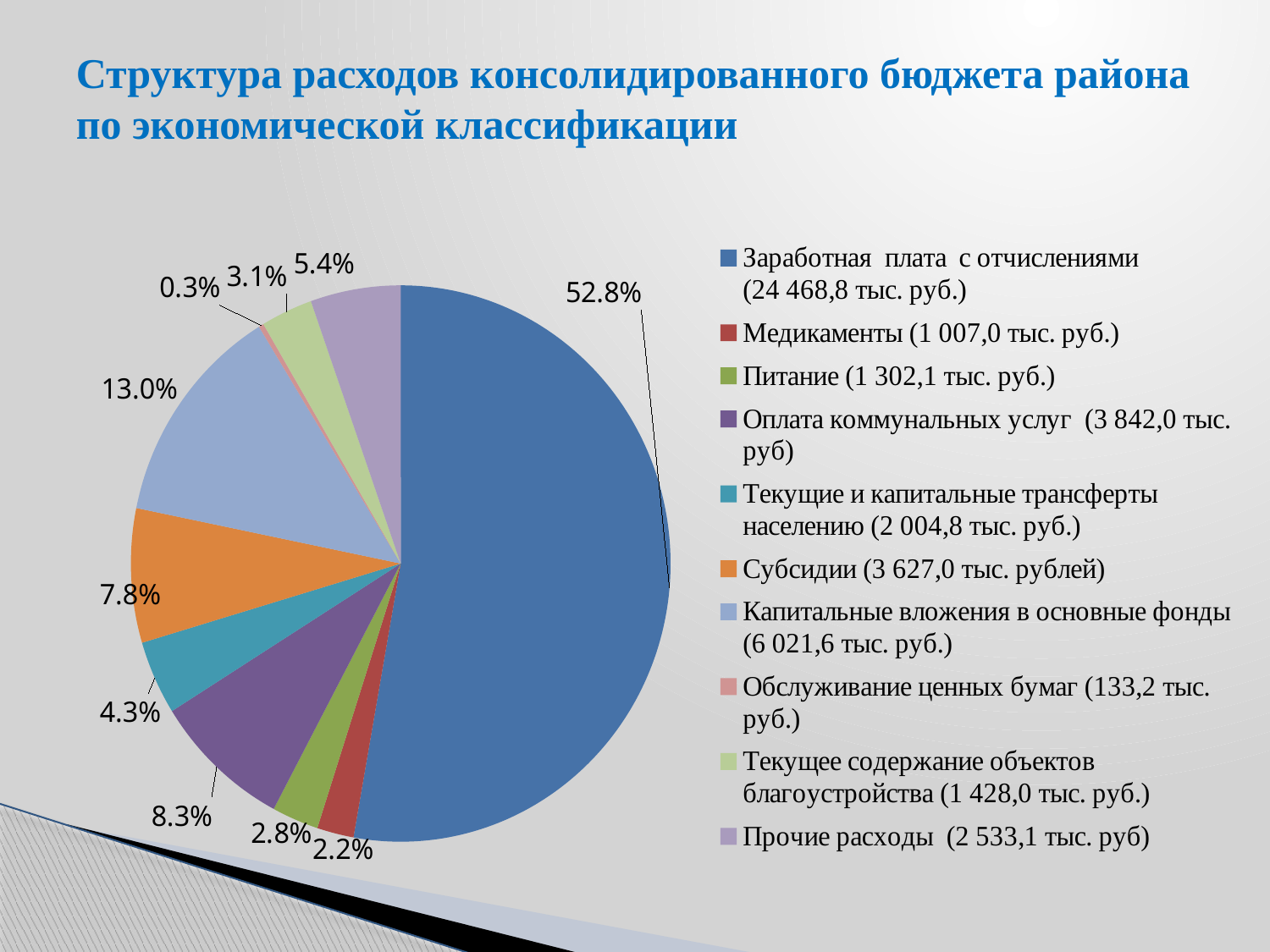
What is the title of the slide? Структура расходов консолидированного бюджета района по экономической классификации What share of the pie does Заработная плата с отчислениями take? 52.8% How many slices does the pie chart have? 10 Which category has the smallest slice of the pie? Обслуживание ценных бумаг Which category has the largest slice of the pie? Заработная плата с отчислениями What percentage is shown for Субсидии? 7.8% What percentage is shown for Капитальные вложения в основные фонды? 13.0% Which is larger: the share for Прочие расходы or the share for Текущие и капитальные трансферты населению? Прочие расходы What percentage is shown for Оплата коммунальных услуг? 8.3% What is the difference in percentage points between Капитальные вложения в основные фонды and Субсидии? 5.2 What kind of chart is shown on the slide? pie chart According to the legend, what amount in thousand rubles is given for Медикаменты? 1 007,0 тыс. руб.